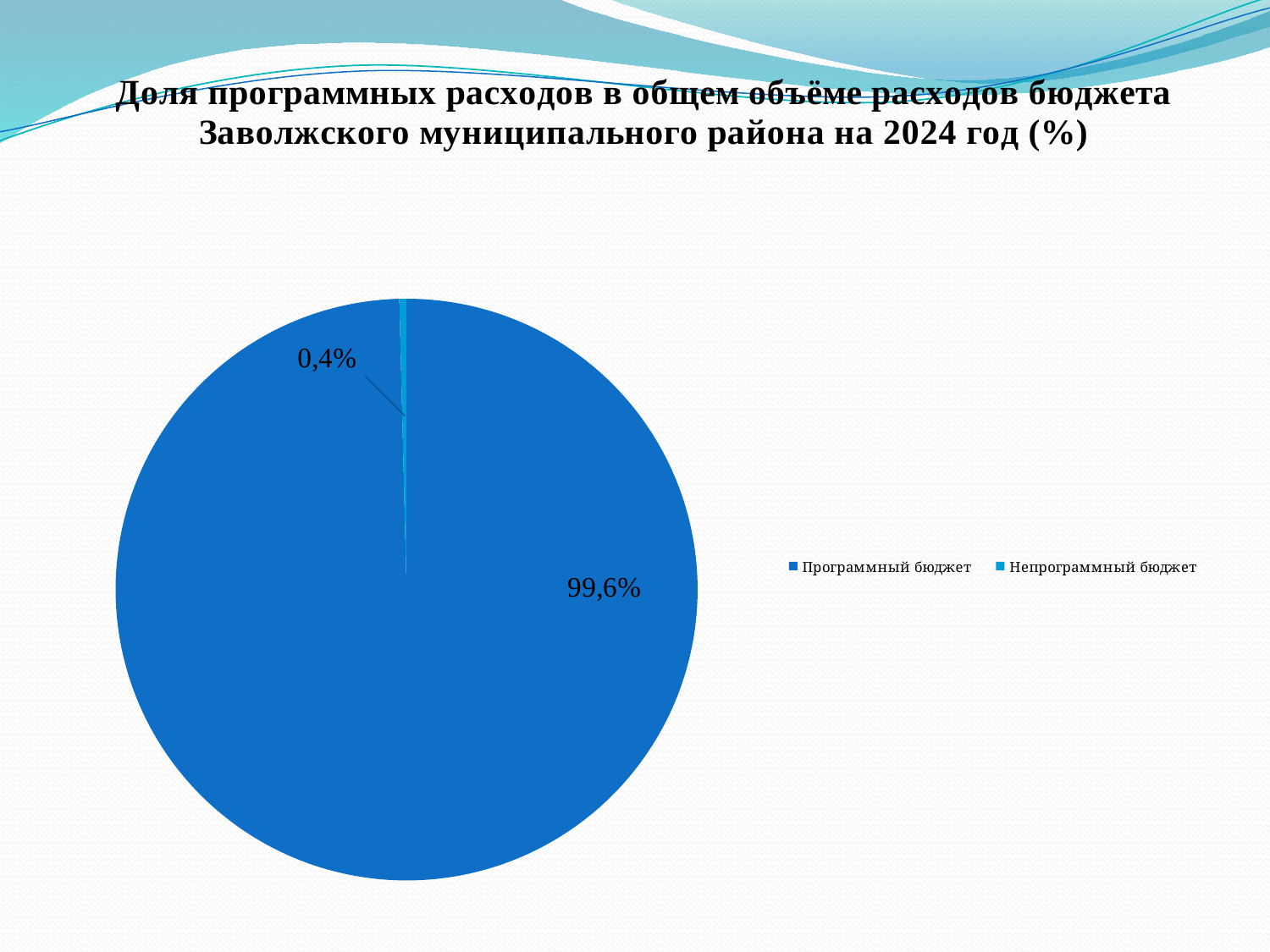
How many slices does the pie chart have? 2 What is the value for Непрограммный бюджет? 0,4% Which category has the smallest share of the pie? Непрограммный бюджет Which legend entry is listed first? Программный бюджет What is the value for Программный бюджет? 99,6% How many entries does the legend list? 2 What is the total of the two slices shown? 100% Which is larger: Программный бюджет or Непрограммный бюджет? Программный бюджет Which category has the largest share of the pie? Программный бюджет What kind of chart is shown on the slide? pie chart What is the difference between the values for Программный бюджет and Непрограммный бюджет? 99,2% What is the title of the chart on the slide? Доля программных расходов в общем объёме расходов бюджета Заволжского муниципального района на 2024 год (%)